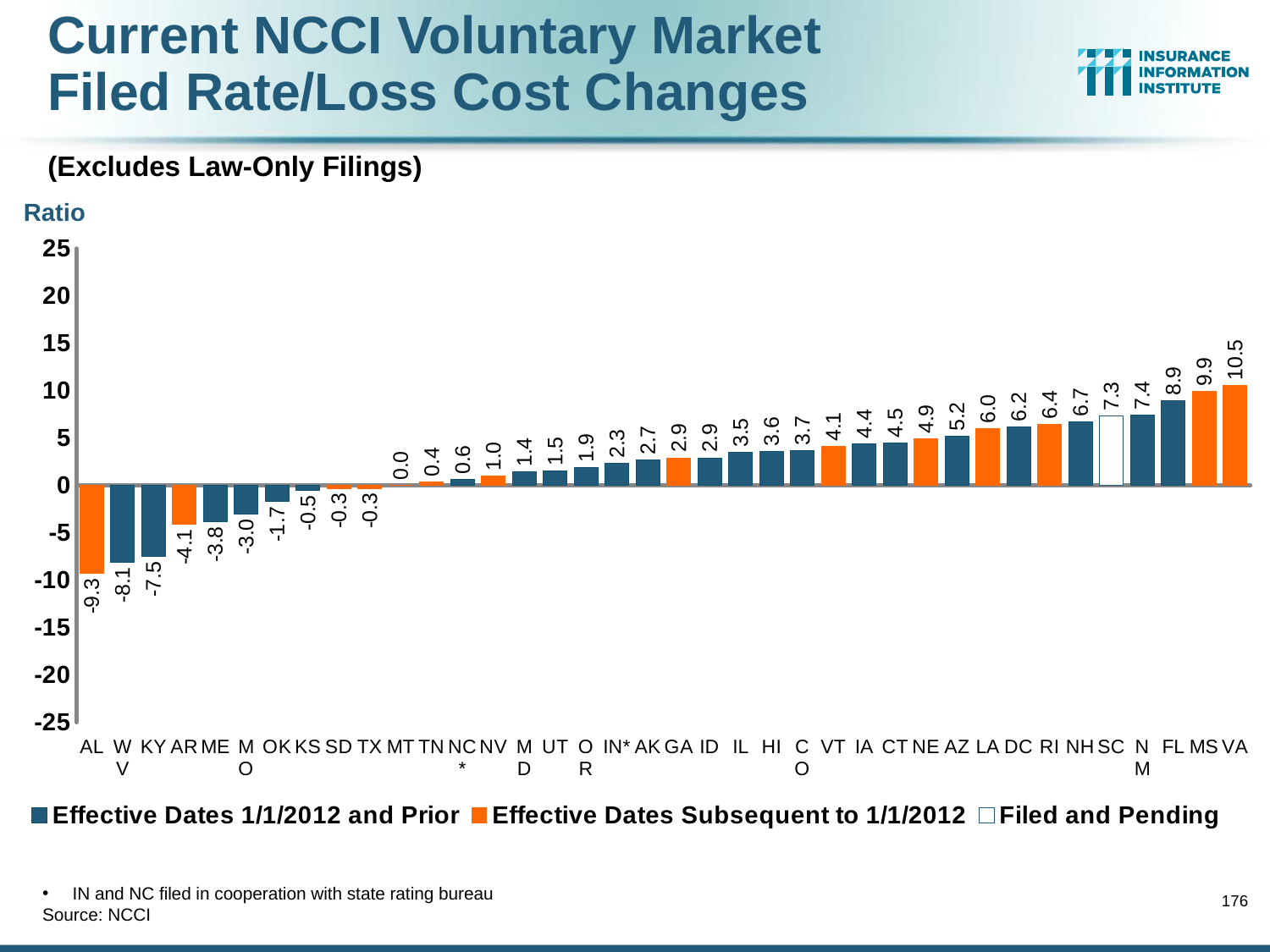
What is the difference between the values for VA and AL? 19.8 Which state has the highest value? VA Do the values rise or fall from left to right along the x axis? Rise How many states are shown on the x axis? 38 How many series does the legend list? 3 Which state's bar is shown as Filed and Pending? SC What is the value for MT? 0.0 What is the value for VA? 10.5 Which state has the lowest value? AL What kind of chart is this? Bar chart What is the value for AL? -9.3 Which is larger, the value for FL or the value for MS? MS